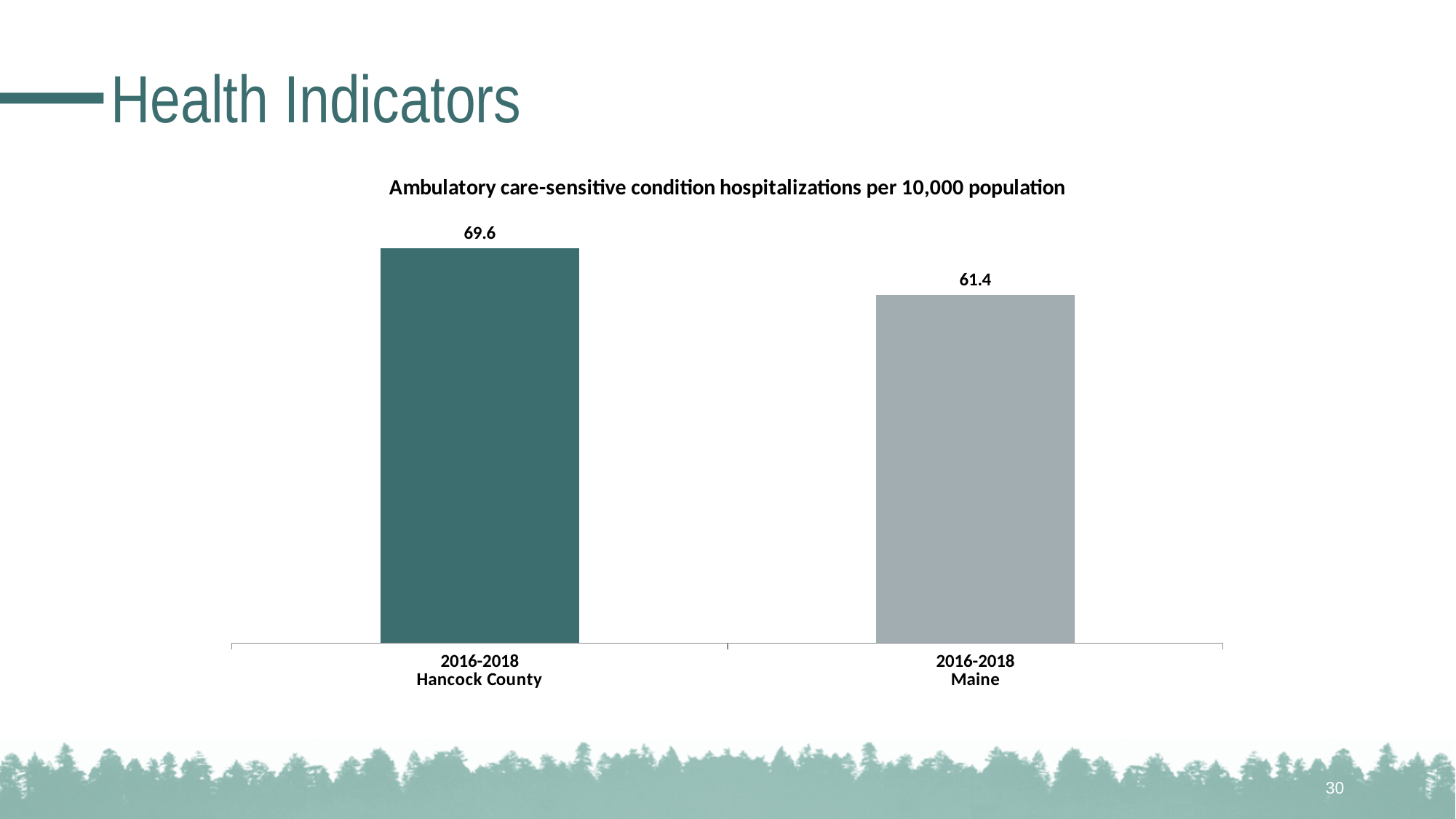
What kind of chart is shown on the slide? Bar chart What is the value for 2016-2018 Maine? 61.4 How many bars are shown in the chart? 2 What is the difference between the Hancock County value and the Maine value? 8.2 Which category has the highest value? 2016-2018 Hancock County What is the value for 2016-2018 Hancock County? 69.6 Which category has the lowest value? 2016-2018 Maine Which is larger, the value for Hancock County or the value for Maine? Hancock County What is the title of the chart? Ambulatory care-sensitive condition hospitalizations per 10,000 population What time period do both bars cover? 2016-2018